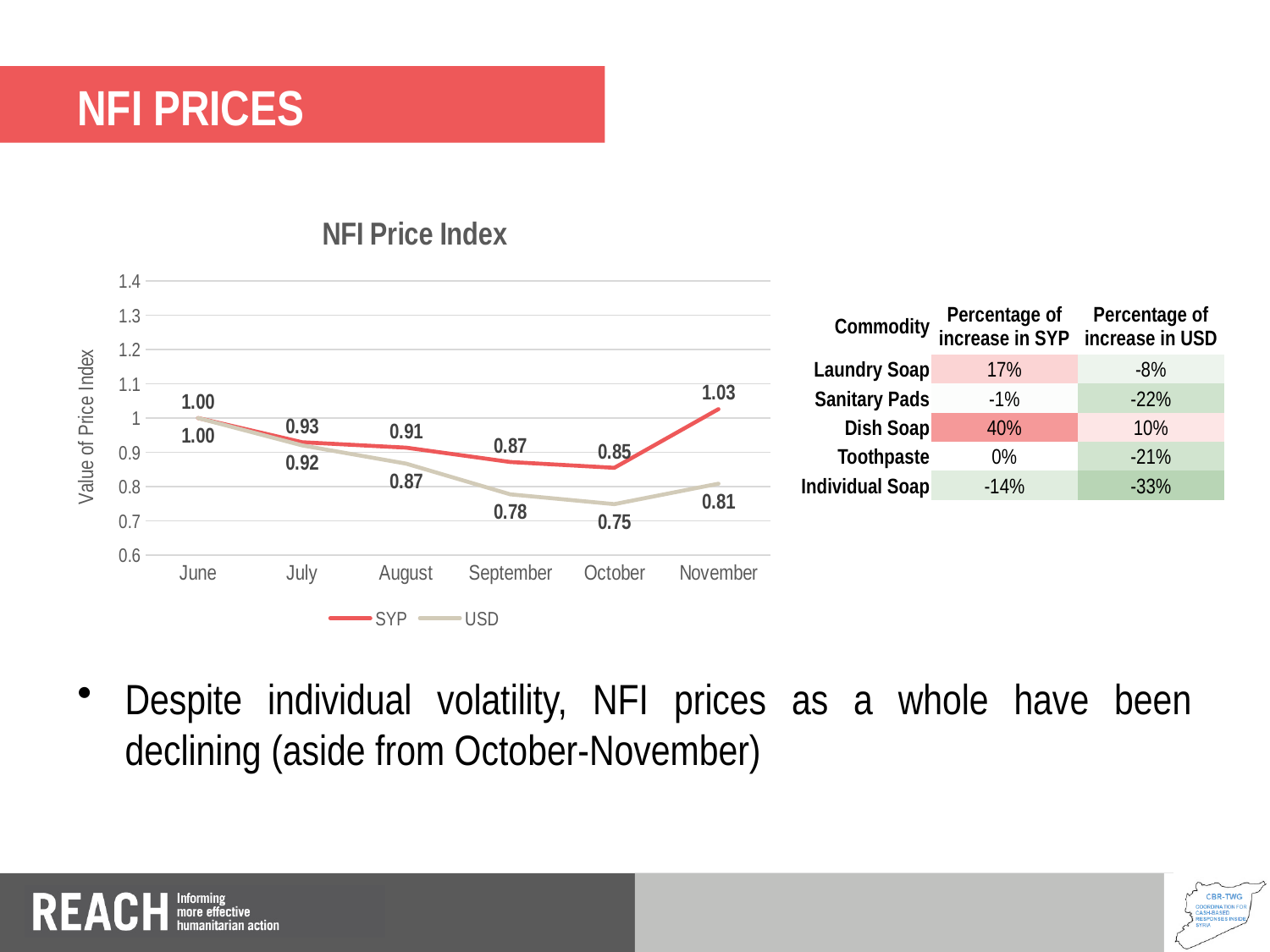
What is the difference between the SYP and USD price index values in September? 0.09 In which month is the SYP price index lowest? October In which month is the USD price index lowest? October What is the USD value of the NFI Price Index in October? 0.75 What is the SYP value of the NFI Price Index in November? 1.03 How many series does the legend of the NFI Price Index chart list? 2 Does the USD price index rise or fall from June to October? Fall Which is larger in August, the SYP price index or the USD price index? SYP What type of chart is the NFI Price Index chart? Line chart In which month is the SYP price index highest? November What is the USD value of the NFI Price Index in September? 0.78 How many months are plotted on the x axis of the NFI Price Index chart? 6